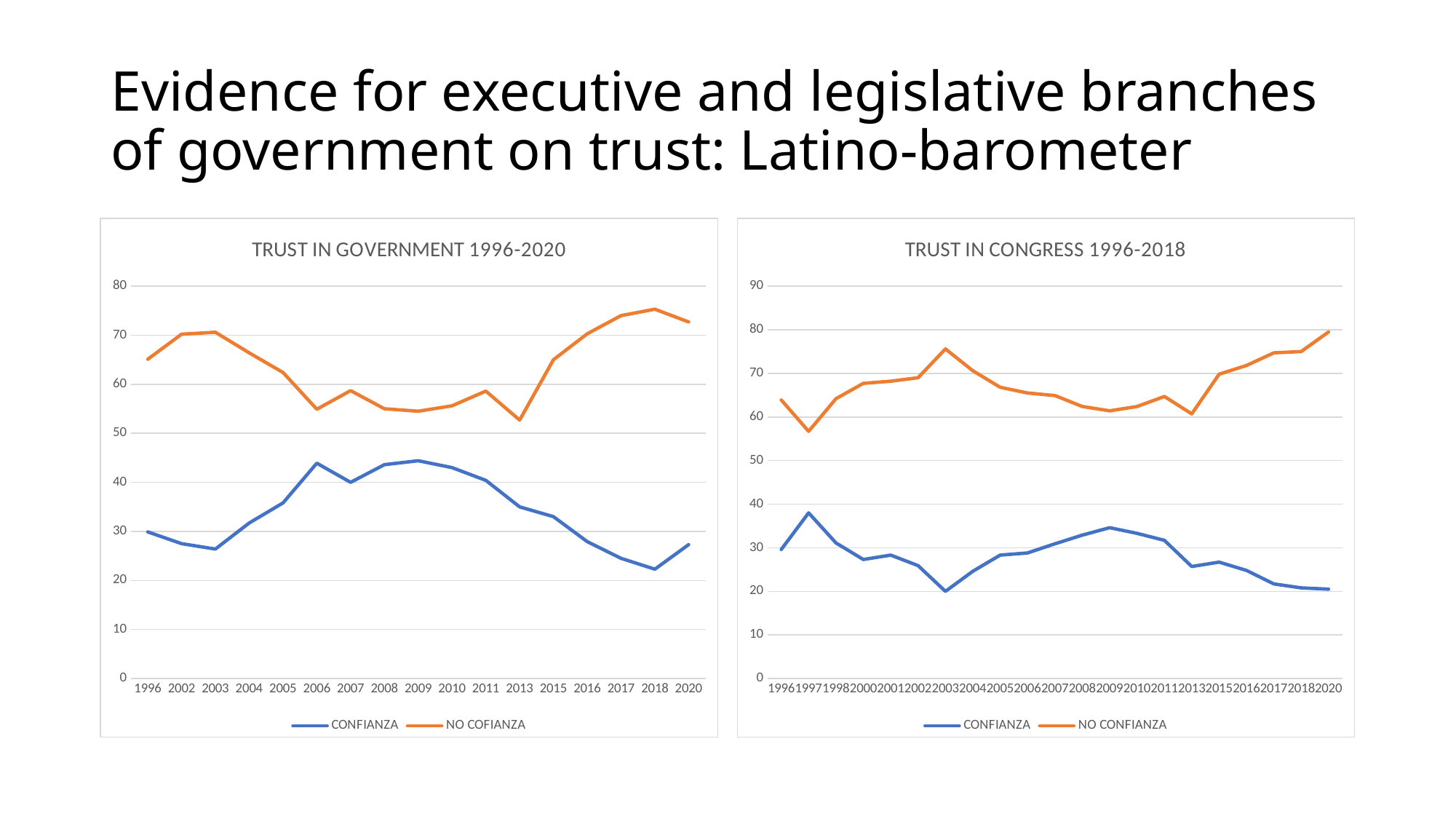
In the TRUST IN CONGRESS 1996-2018 chart, is the NO CONFIANZA value for 2003 greater or less than 70? greater In the TRUST IN GOVERNMENT 1996-2020 chart, which series has the larger value in 2006, CONFIANZA or NO COFIANZA? NO COFIANZA In the TRUST IN CONGRESS 1996-2018 chart, in which year is the NO CONFIANZA series highest? 2020 In the TRUST IN GOVERNMENT 1996-2020 chart, does the CONFIANZA series rise or fall from 2009 to 2018? Fall How many years are plotted on the x axis of the TRUST IN CONGRESS 1996-2018 chart? 21 In the TRUST IN CONGRESS 1996-2018 chart, in which year is the NO CONFIANZA series lowest? 1997 How many series does the legend of the TRUST IN CONGRESS 1996-2018 chart list? 2 In the TRUST IN CONGRESS 1996-2018 chart, in which year is the CONFIANZA series highest? 1997 In the TRUST IN GOVERNMENT 1996-2020 chart, in which year is the CONFIANZA series lowest? 2018 How many years are plotted on the x axis of the TRUST IN GOVERNMENT 1996-2020 chart? 17 What type of chart is the TRUST IN GOVERNMENT 1996-2020 chart? Line chart In the TRUST IN GOVERNMENT 1996-2020 chart, is the NO COFIANZA value for 2013 greater or less than 60? less